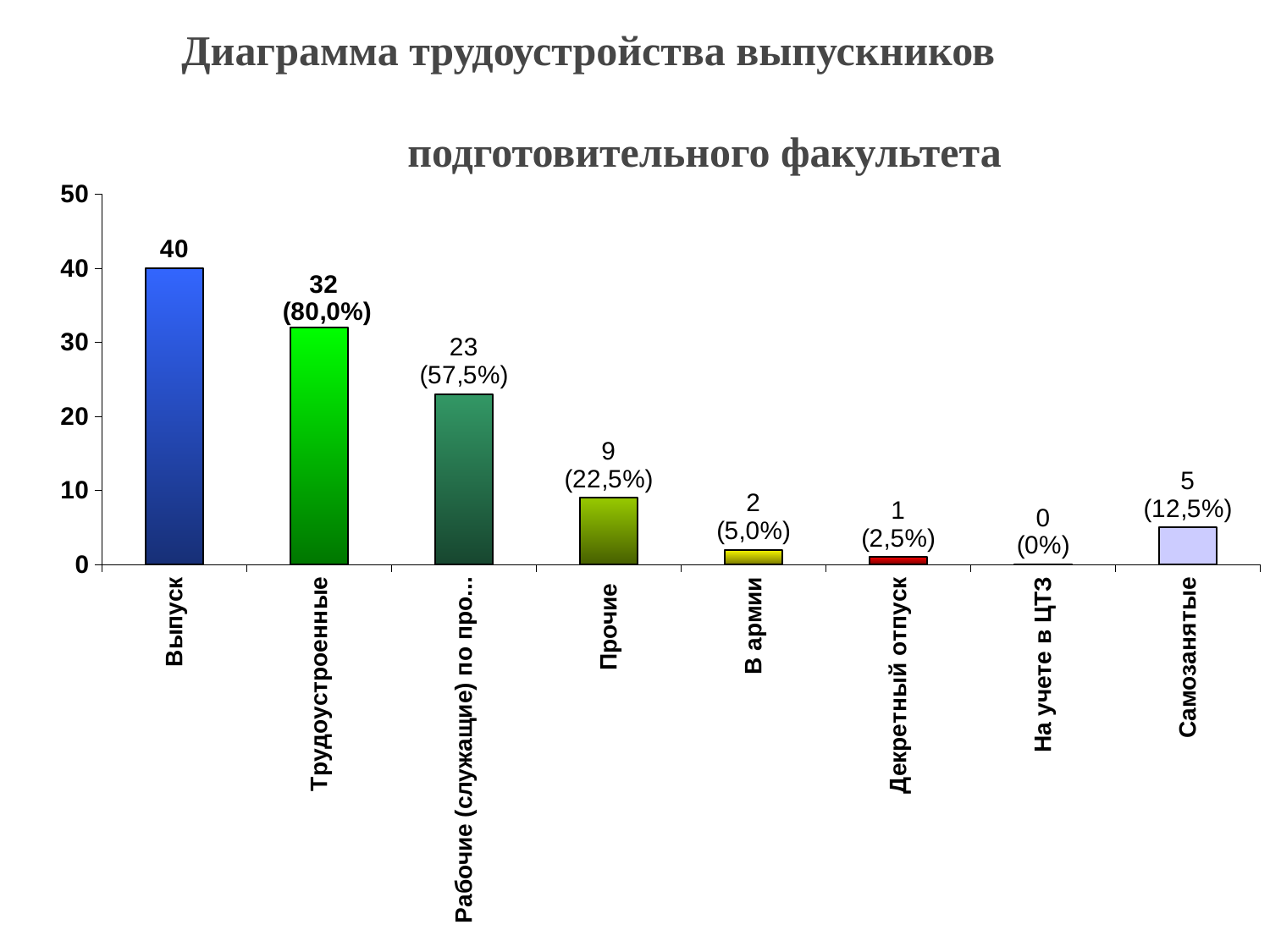
What percentage is shown for Прочие? 22,5% What is the value for Выпуск? 40 Which category has the highest value? Выпуск What is the value for На учете в ЦТЗ? 0 How many categories are shown on the x axis? 8 What percentage is shown for Декретный отпуск? 2,5% Which category has the lowest value? На учете в ЦТЗ Which is larger, the value for В армии or the value for Самозанятые? Самозанятые What is the value for Трудоустроенные? 32 What kind of chart is shown on the slide? Bar chart What is the value for Самозанятые? 5 What is the difference between the values for Выпуск and Трудоустроенные? 8